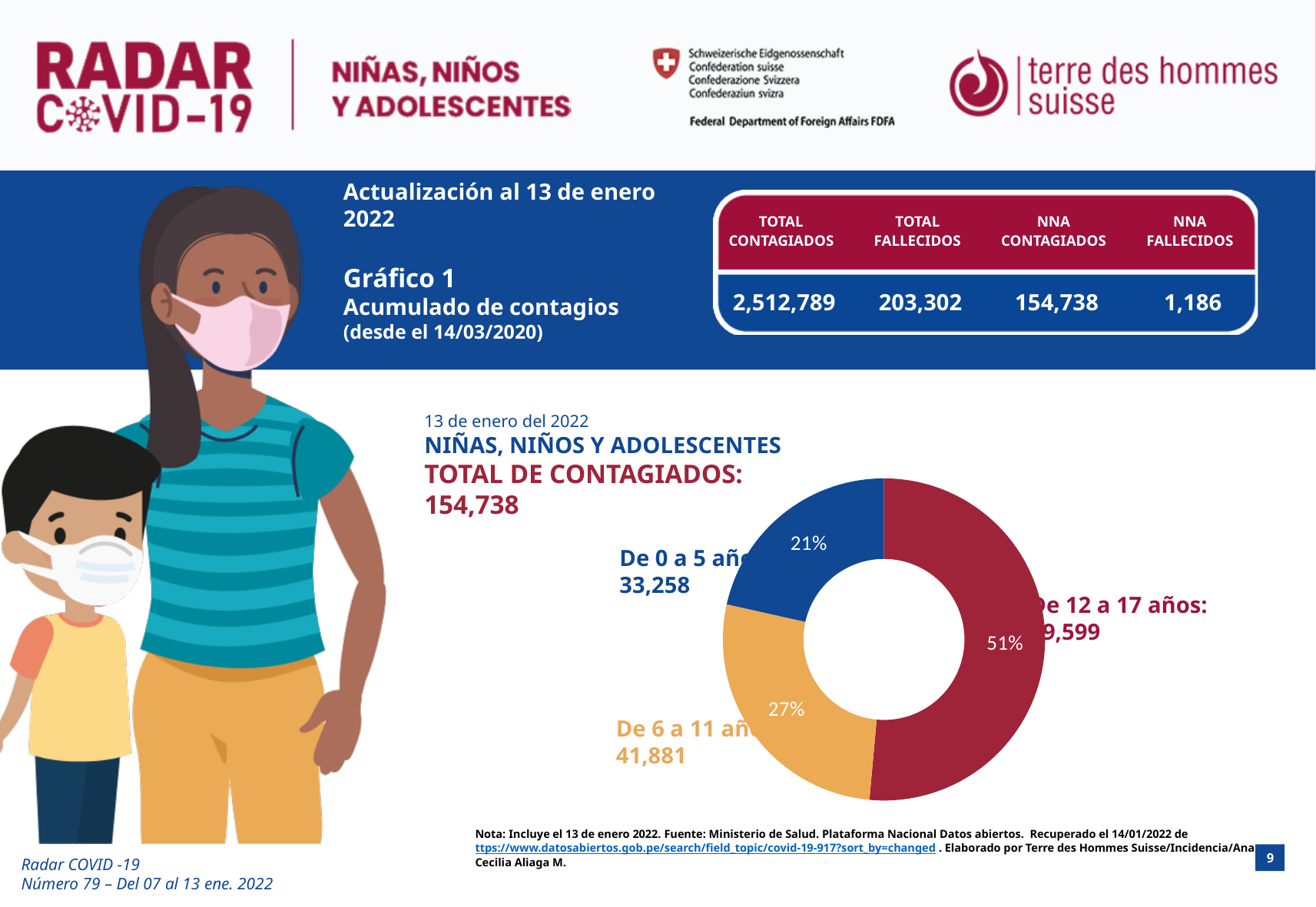
What is the difference in contagiados between 'De 6 a 11 años' and 'De 0 a 5 años'? 8,623 What share of the donut chart does the group 'De 12 a 17 años' represent? 51% Which group has more contagiados, 'De 6 a 11 años' or 'De 0 a 5 años'? De 6 a 11 años What total de contagiados is stated next to the donut chart for niñas, niños y adolescentes? 154,738 Which age group has the smallest share of contagiados in the donut chart? De 0 a 5 años How many contagiados are shown for the group 'De 6 a 11 años'? 41,881 How many age groups are shown in the donut chart? 3 Which age group has the largest share of contagiados in the donut chart? De 12 a 17 años How many contagiados are shown for the group 'De 0 a 5 años'? 33,258 What share of the donut chart does the group 'De 0 a 5 años' represent? 21% What share of the donut chart does the group 'De 6 a 11 años' represent? 27% What kind of chart is shown on the slide? donut chart